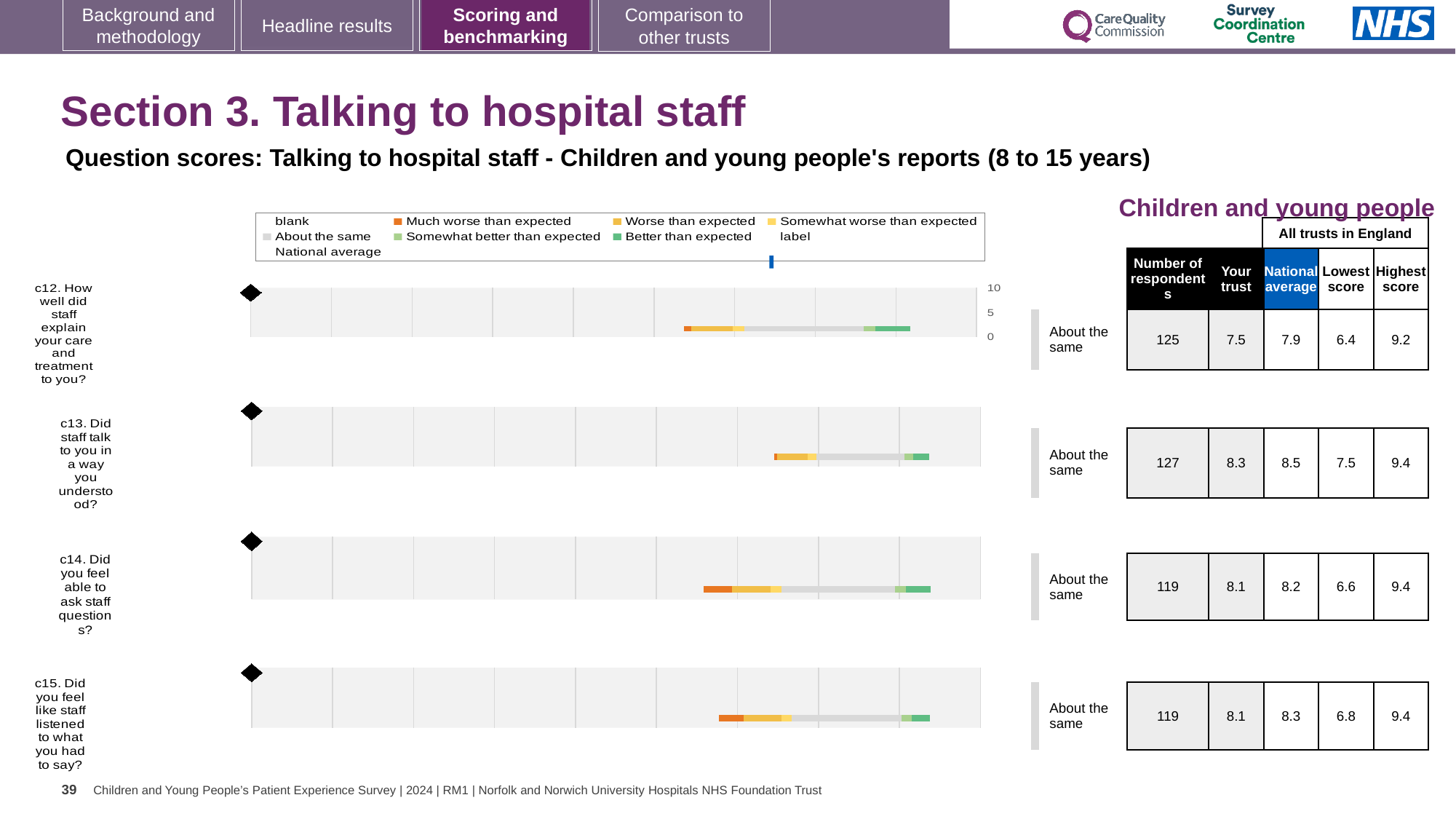
How many questions (c12 to c15) are charted on the slide? 4 What kind of chart is used to show the question scores for c12 to c15? bar chart For c12, which is larger: the 'Your trust' score or the national average? National average For c13, what is the difference between the national average and the 'Your trust' score? 0.2 For c12 (How well did staff explain your care and treatment to you?), what is the 'Your trust' score? 7.5 For c13 (Did staff talk to you in a way you understood?), what is the national average score? 8.5 For c14 (Did you feel able to ask staff questions?), what is the lowest score among all trusts in England? 6.6 Which question has the highest 'Your trust' score? c13 Which question has the lowest 'Your trust' score? c12 What benchmark category is shown next to each of the four question charts? About the same For c15 (Did you feel like staff listened to what you had to say?), how many respondents were there? 119